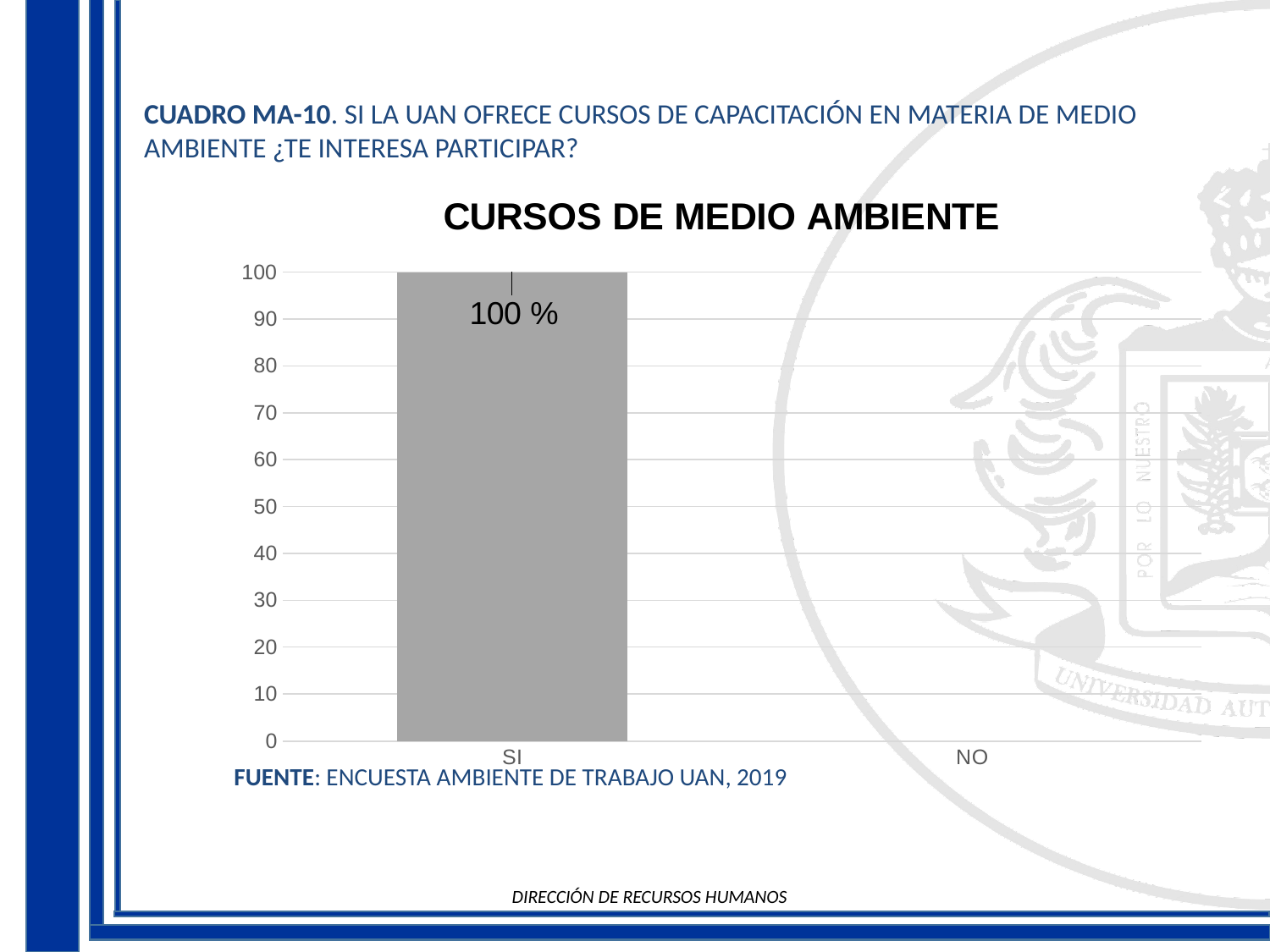
What source is cited below the chart? ENCUESTA AMBIENTE DE TRABAJO UAN, 2019 What is the highest tick value on the y axis of the chart? 100 Which category has the lowest value in the chart? NO Which is larger, the value for SI or the value for NO? SI Is the value for SI greater or less than 50? greater What kind of chart is shown on the slide? bar chart What is the value shown for SI in the CURSOS DE MEDIO AMBIENTE chart? 100 % How many categories are shown on the x axis of the chart? 2 What is the title of the chart? CURSOS DE MEDIO AMBIENTE Which category has the highest value in the chart? SI